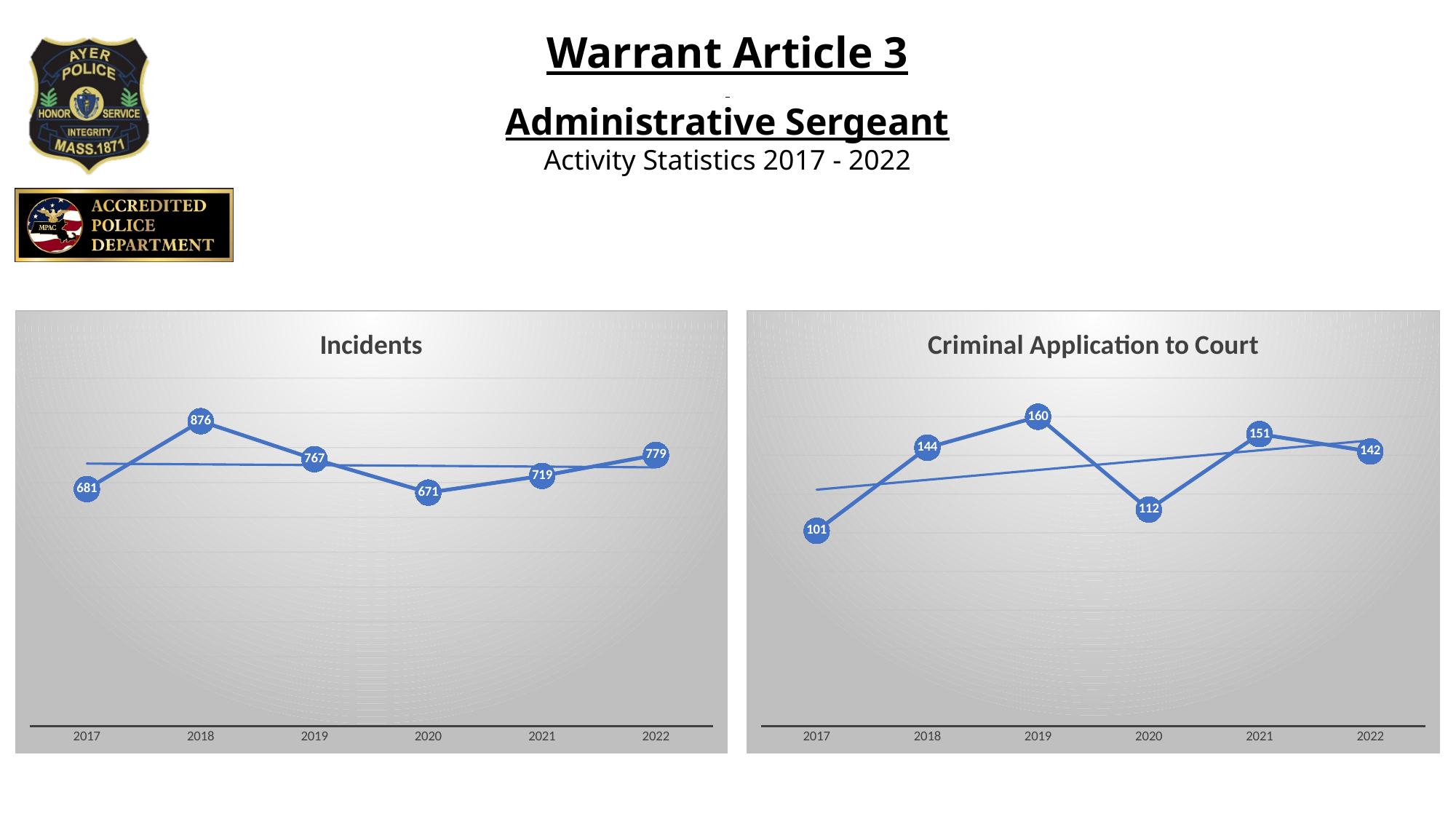
In the Incidents chart, what is the value for 2018? 876 In the Incidents chart, do the values rise or fall from 2020 to 2022? rise In the Incidents chart, what is the difference between the 2018 and 2017 values? 195 In the Criminal Application to Court chart, which year has the lowest value? 2017 In the Criminal Application to Court chart, what is the value for 2021? 151 What kind of chart is the Incidents chart? line chart In the Incidents chart, how many data points are plotted? 6 In the Criminal Application to Court chart, which is larger, the value for 2018 or the value for 2022? 2018 In the Incidents chart, which year has the lowest value? 2020 In the Criminal Application to Court chart, what is the difference between the 2019 and 2020 values? 48 In the Criminal Application to Court chart, which year has the highest value? 2019 What is the title of the chart on the right side of the slide? Criminal Application to Court